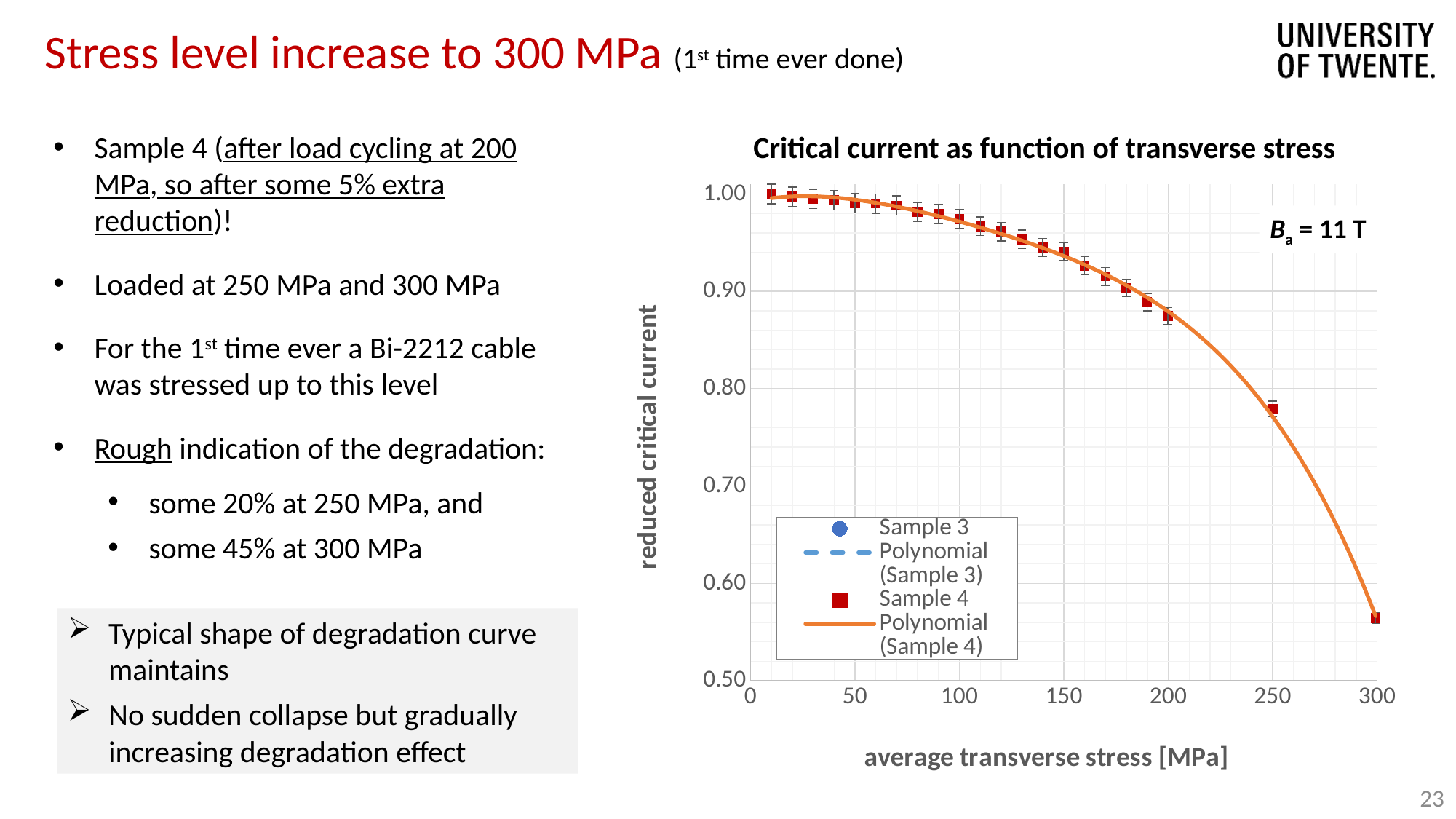
What is the title of the chart? Critical current as function of transverse stress At which average transverse stress is the reduced critical current lowest? 300 MPa What is the label of the x axis? average transverse stress [MPa] Is the reduced critical current for Sample 4 at 300 MPa greater or less than 0.60? less What kind of chart is shown on the slide? Scatter chart with fitted polynomial curves What is the maximum value shown on the x axis? 300 Is the reduced critical current for Sample 4 at 200 MPa greater or less than 0.90? less Which has the larger reduced critical current: the point at 250 MPa or the point at 300 MPa? 250 MPa How many entries does the chart legend list? 4 Does the reduced critical current rise or fall as the average transverse stress increases? Falls Is the reduced critical current for Sample 4 at 100 MPa greater or less than 0.90? greater